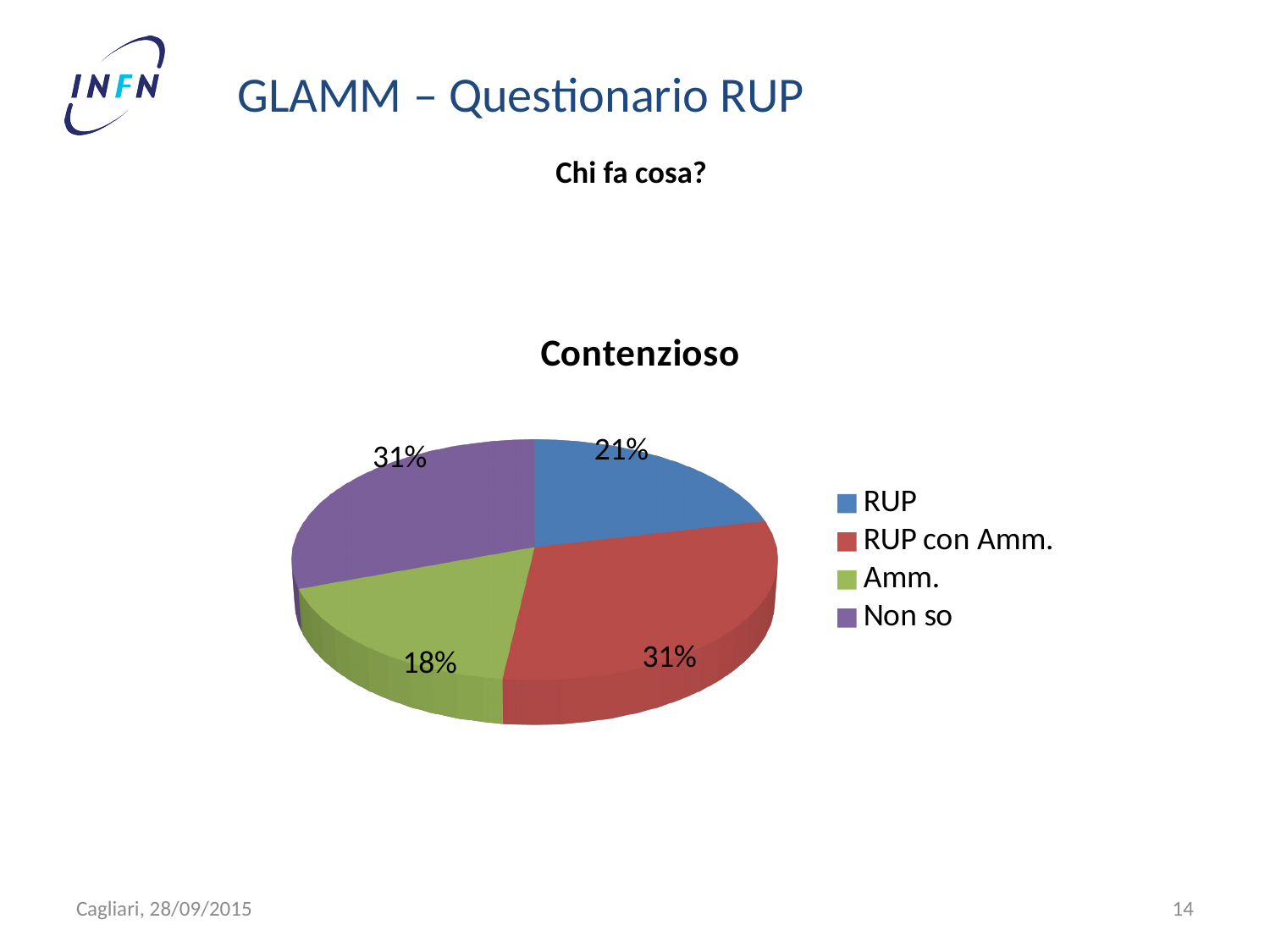
What colour is the slice for Amm.? green How many entries does the legend list? 4 What is the title of the chart? Contenzioso Which category has the smallest slice of the pie? Amm. Which is larger, the share for RUP or the share for Non so? Non so What is the difference between the shares of RUP con Amm. and Amm.? 13% What kind of chart is shown on the slide? pie chart What share of the pie does Amm. have? 18% What share of the pie does RUP have? 21% How many slices does the pie chart have? 4 What share of the pie does RUP con Amm. have? 31%